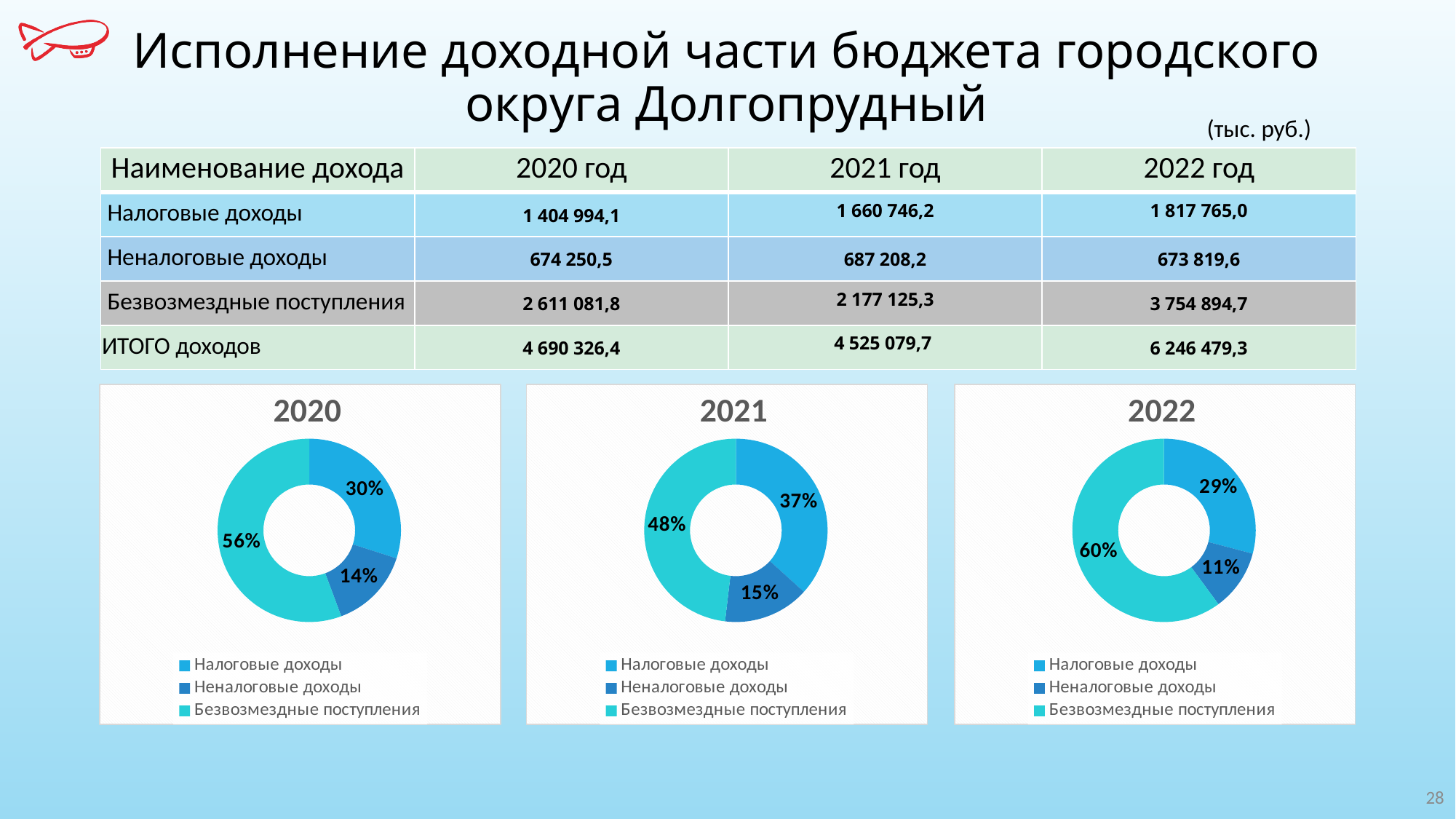
What kind of chart is the 2021 chart? Doughnut chart In the 2022 chart, which category has the largest share? Безвозмездные поступления How many slices does the 2022 chart have? 3 In the 2022 chart, what share do Неналоговые доходы have? 11% In the 2021 chart, which is larger: Налоговые доходы or Неналоговые доходы? Налоговые доходы In the 2022 chart, what is the combined share of Налоговые доходы and Неналоговые доходы? 40% How many series does the legend of the 2020 chart list? 3 In the 2020 chart, what share do Безвозмездные поступления have? 56% What is the title of the chart on the right of the slide? 2022 In the 2021 chart, what share do Налоговые доходы have? 37% In the 2020 chart, what is the difference in percentage points between Безвозмездные поступления and Налоговые доходы? 26 In the 2021 chart, which category has the smallest share? Неналоговые доходы